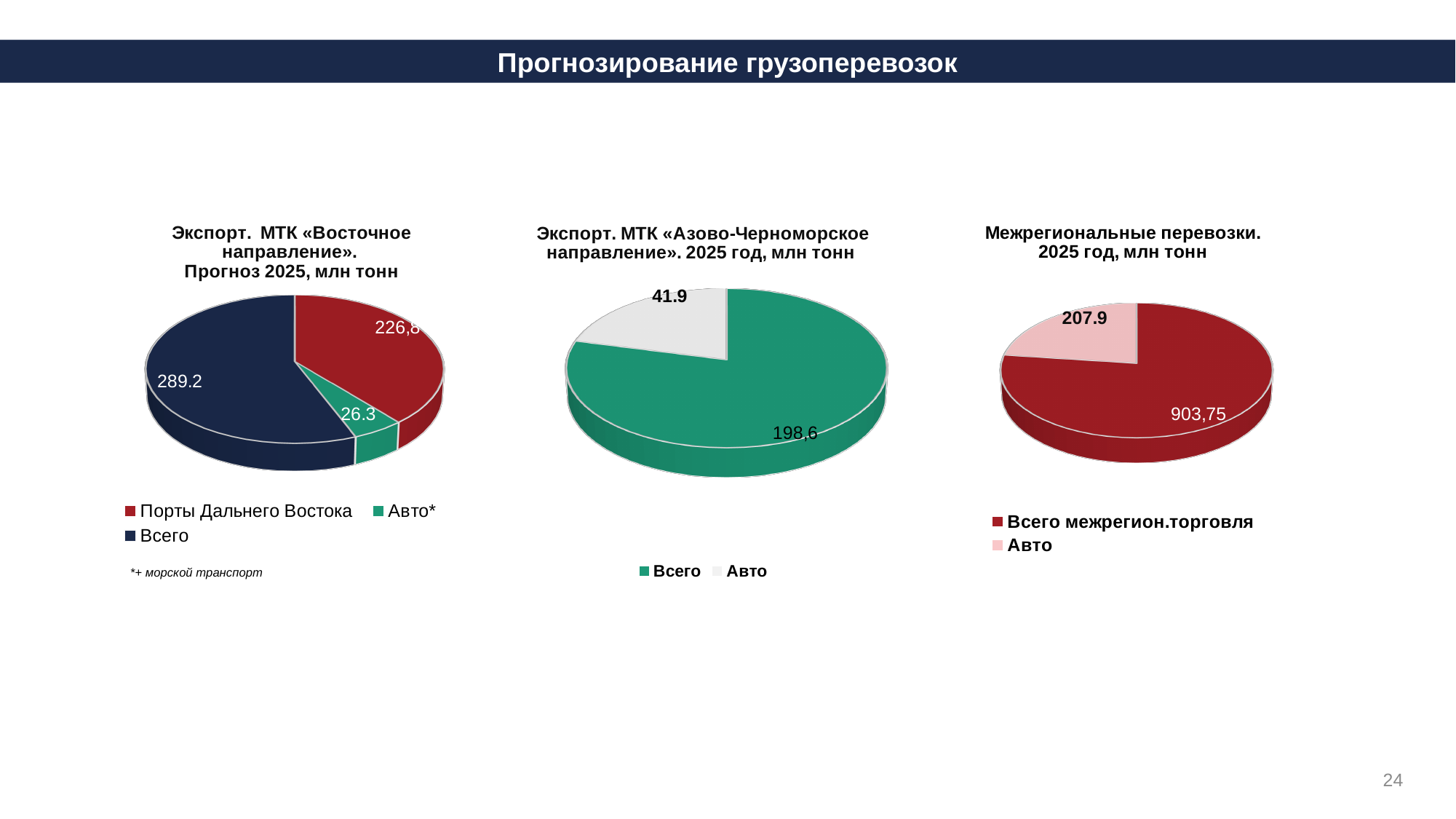
In the right chart (Межрегиональные перевозки), what is the value for Всего межрегион.торговля? 903,75 In the middle chart (Экспорт. МТК «Азово-Черноморское направление»), which is larger, Всего or Авто? Всего In the left chart (Экспорт. МТК «Восточное направление»), what is the value for Порты Дальнего Востока? 226,8 In the middle chart (Экспорт. МТК «Азово-Черноморское направление»), what is the value for Всего? 198,6 In the left chart (Экспорт. МТК «Восточное направление»), what is the value for Авто*? 26.3 In the left chart (Экспорт. МТК «Восточное направление»), what is the difference between Всего and Авто*? 262.9 In the right chart (Межрегиональные перевозки), what is the value for Авто? 207.9 In the left chart (Экспорт. МТК «Восточное направление»), what is the value for Всего? 289.2 In the left chart (Экспорт. МТК «Восточное направление»), how many entries does the legend list? 3 In the left chart (Экспорт. МТК «Восточное направление»), which category has the smallest slice? Авто* What type of chart is the right chart (Межрегиональные перевозки)? Pie chart In the middle chart (Экспорт. МТК «Азово-Черноморское направление»), what is the value for Авто? 41.9